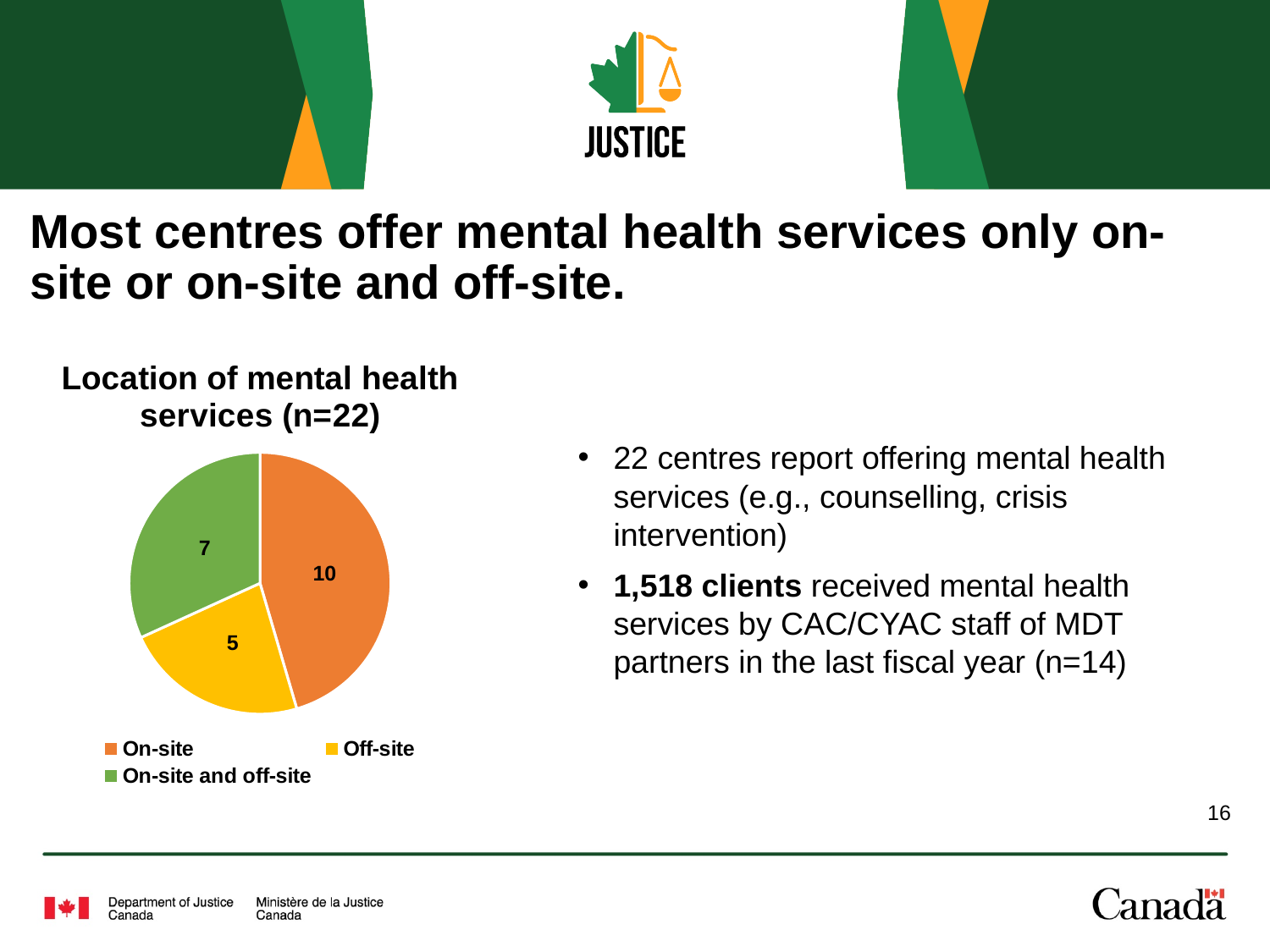
How many centres offer mental health services off-site only? 5 How many categories does the pie chart have? 3 How many centres offer mental health services both on-site and off-site? 7 What is the title of the chart? Location of mental health services (n=22) What share of the pie does the On-site slice represent? 10 of 22 What type of chart is shown on the slide? pie chart Which location category has the smallest slice of the pie? Off-site What colour is the Off-site slice in the pie chart? yellow What is the difference between the number of centres offering services on-site and those offering services off-site? 5 How many centres offer mental health services on-site only? 10 Which is larger: the number of centres offering services on-site and off-site, or the number offering services off-site only? On-site and off-site Which location category has the largest slice of the pie? On-site